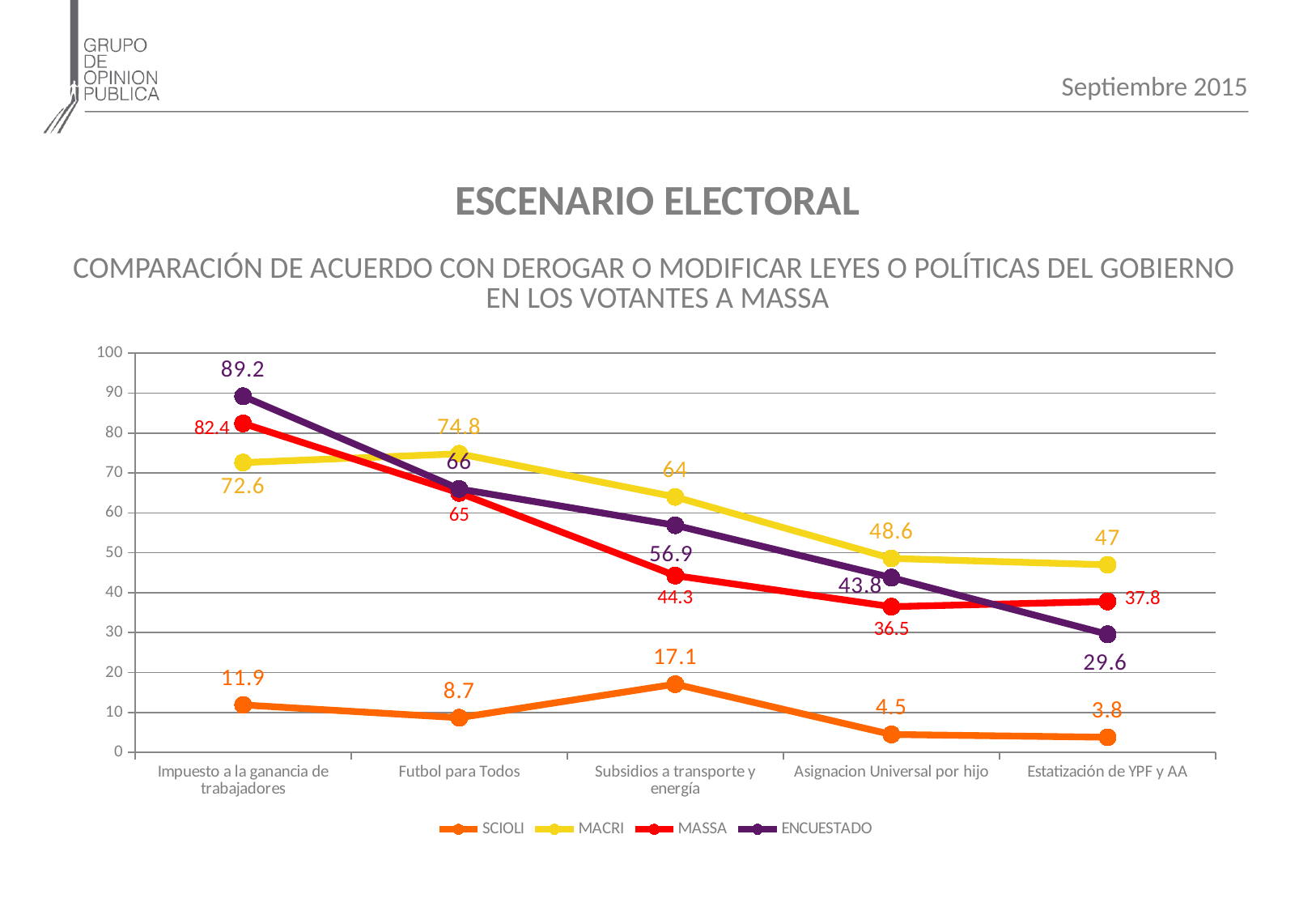
What is the difference between the MACRI and MASSA values at Asignacion Universal por hijo? 12.1 What is the value for MASSA at Subsidios a transporte y energía? 44.3 How many categories are shown on the x axis? 5 At Estatización de YPF y AA, which is larger: the MASSA value or the ENCUESTADO value? MASSA For which category is the SCIOLI value highest? Subsidios a transporte y energía What is the value for MACRI at Futbol para Todos? 74.8 Does the ENCUESTADO series rise or fall from left to right across the categories? fall For which category is the ENCUESTADO value lowest? Estatización de YPF y AA How many series does the legend list? 4 What type of chart is shown on the slide? line chart What is the value for SCIOLI at Estatización de YPF y AA? 3.8 What is the value for ENCUESTADO at Impuesto a la ganancia de trabajadores? 89.2